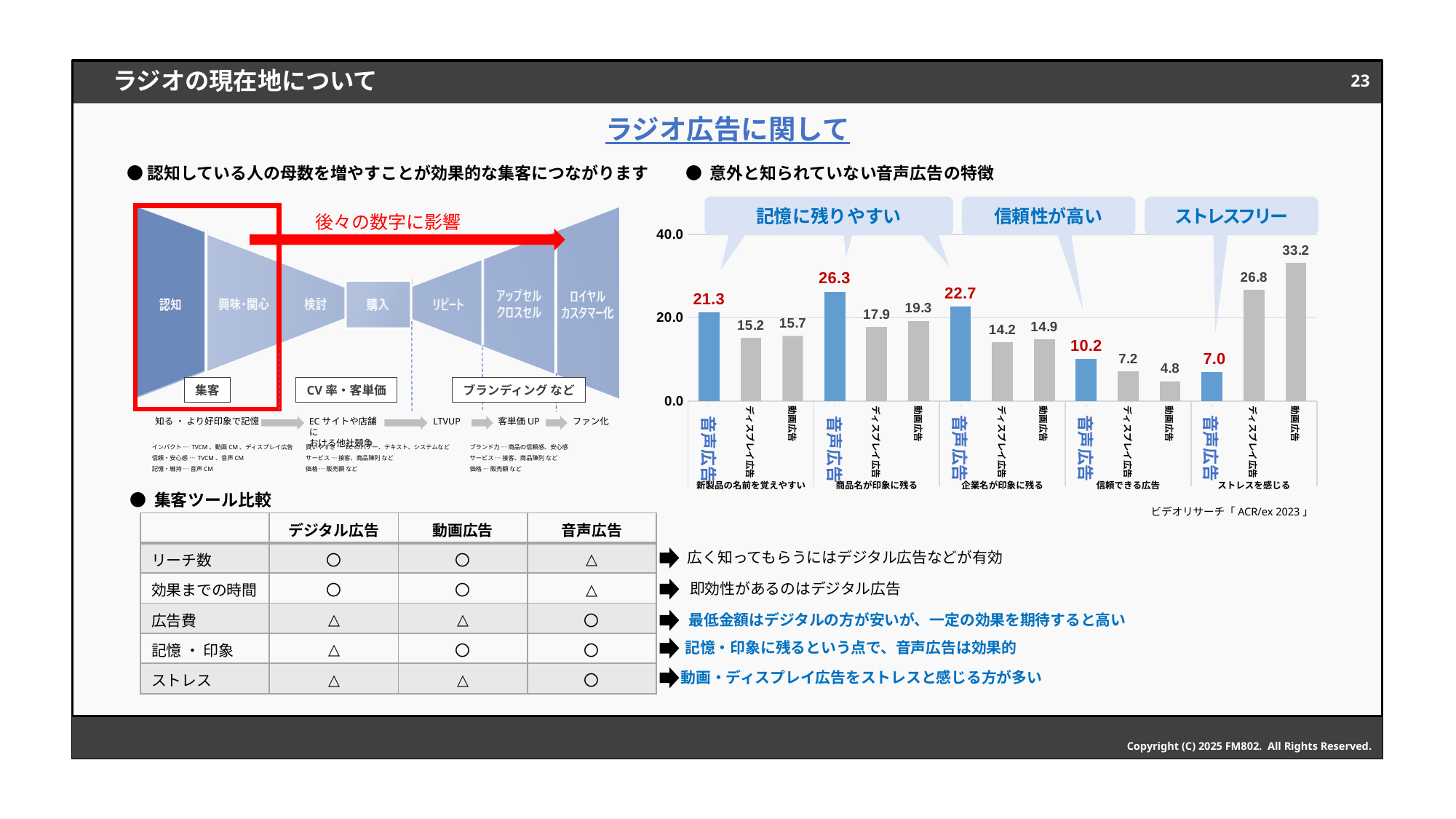
What is the value for 動画広告 in the ストレスを感じる group of the bar chart? 33.2 What is the source cited below the bar chart? ビデオリサーチ「ACR/ex 2023」 What is the value for 音声広告 in the 商品名が印象に残る group of the bar chart? 26.3 What is the difference between 音声広告 and ディスプレイ広告 in the 企業名が印象に残る group? 8.5 In the 信頼できる広告 group, which is larger: ディスプレイ広告 or 動画広告? ディスプレイ広告 What is the value for ディスプレイ広告 in the 信頼できる広告 group of the bar chart? 7.2 In the 新製品の名前を覚えやすい group, which ad type has the highest value? 音声広告 How many category groups are shown along the x axis of the bar chart? 5 In the ストレスを感じる group, which ad type has the lowest value? 音声広告 How many bars are in each category group of the bar chart? 3 Is the value for 動画広告 in the ストレスを感じる group greater or less than 20.0? greater What kind of chart is shown on the right side of the slide? bar chart